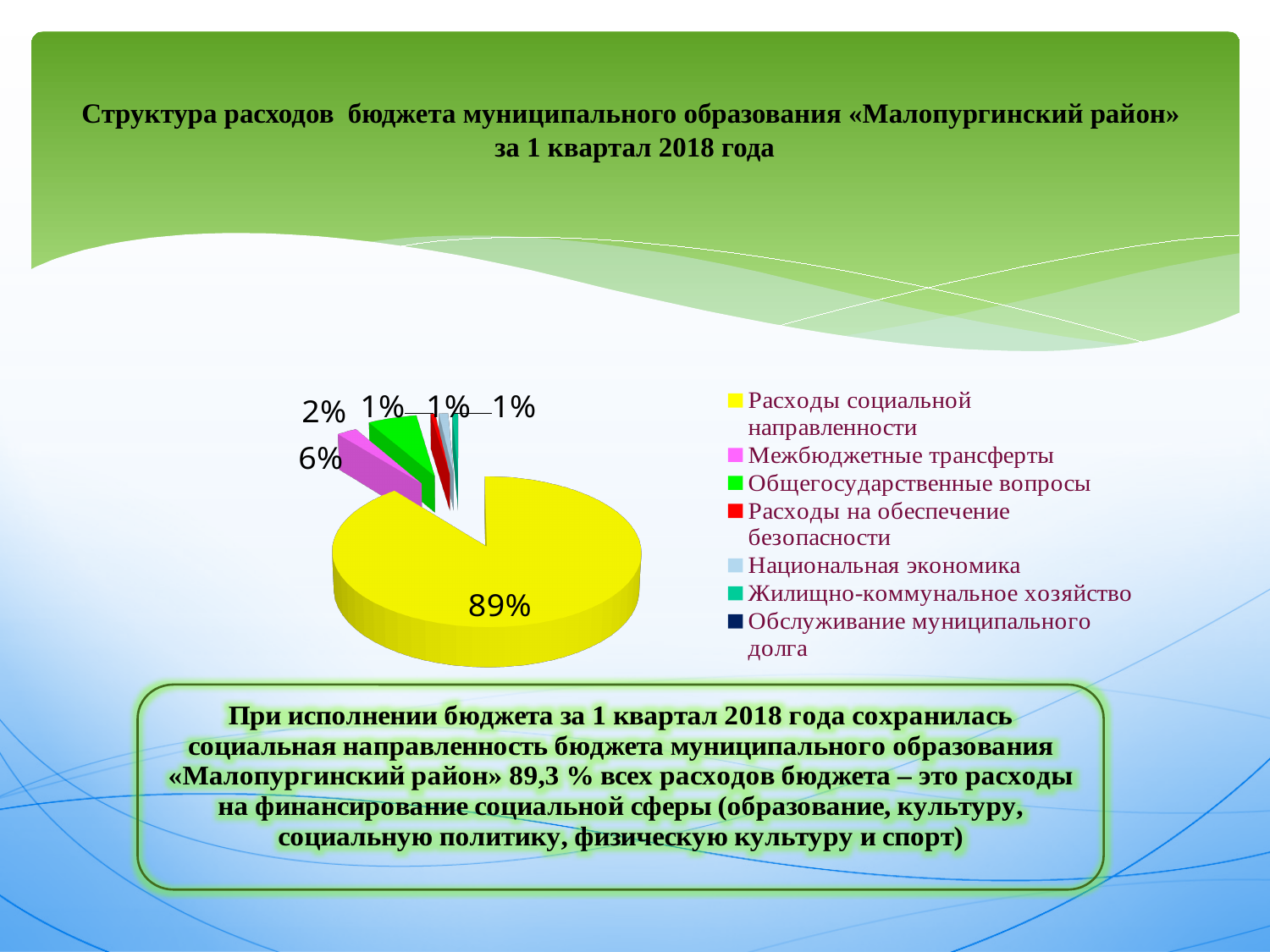
What is the difference in percentage points between the Расходы социальной направленности slice and the Межбюджетные трансферты slice? 87 What share of the pie is labelled for Общегосударственные вопросы? 6% Which slice is larger: Межбюджетные трансферты or Общегосударственные вопросы? Общегосударственные вопросы How many categories does the legend list? 7 Which category has the largest share of the pie? Расходы социальной направленности What kind of chart is shown on the slide? pie chart Which period does the chart title say the budget expenditure structure refers to? 1 квартал 2018 года What colour is the largest slice of the pie? yellow Is the share for Расходы социальной направленности greater or less than 50%? greater What share of the pie is labelled for Расходы социальной направленности? 89% What share of the pie is labelled for Межбюджетные трансферты? 2%